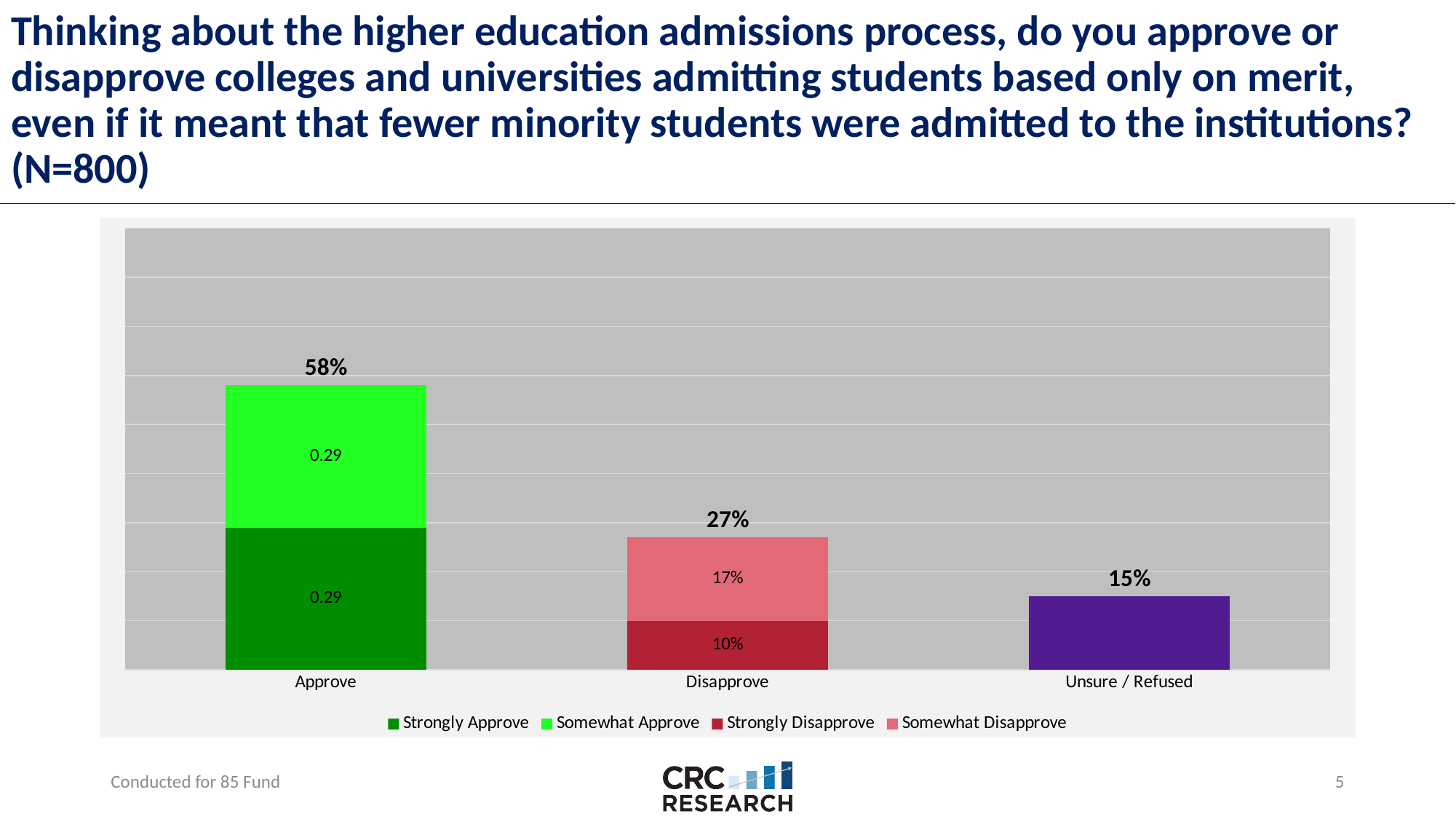
Which category has the lowest total value? Unsure / Refused What kind of chart is shown on the slide? Stacked bar chart What label is printed on the Strongly Approve segment of the Approve bar? 0.29 What is the value of the Somewhat Disapprove segment in the Disapprove bar? 17% Within the Disapprove bar, which segment is larger: Strongly Disapprove or Somewhat Disapprove? Somewhat Disapprove What is the difference between the Approve total and the Disapprove total? 31% What is the total value shown above the Disapprove bar? 27% What is the value for Unsure / Refused? 15% Which category has the highest total value? Approve What is the value of the Strongly Disapprove segment in the Disapprove bar? 10% How many series does the legend list? 4 What is the total value shown above the Approve bar? 58%